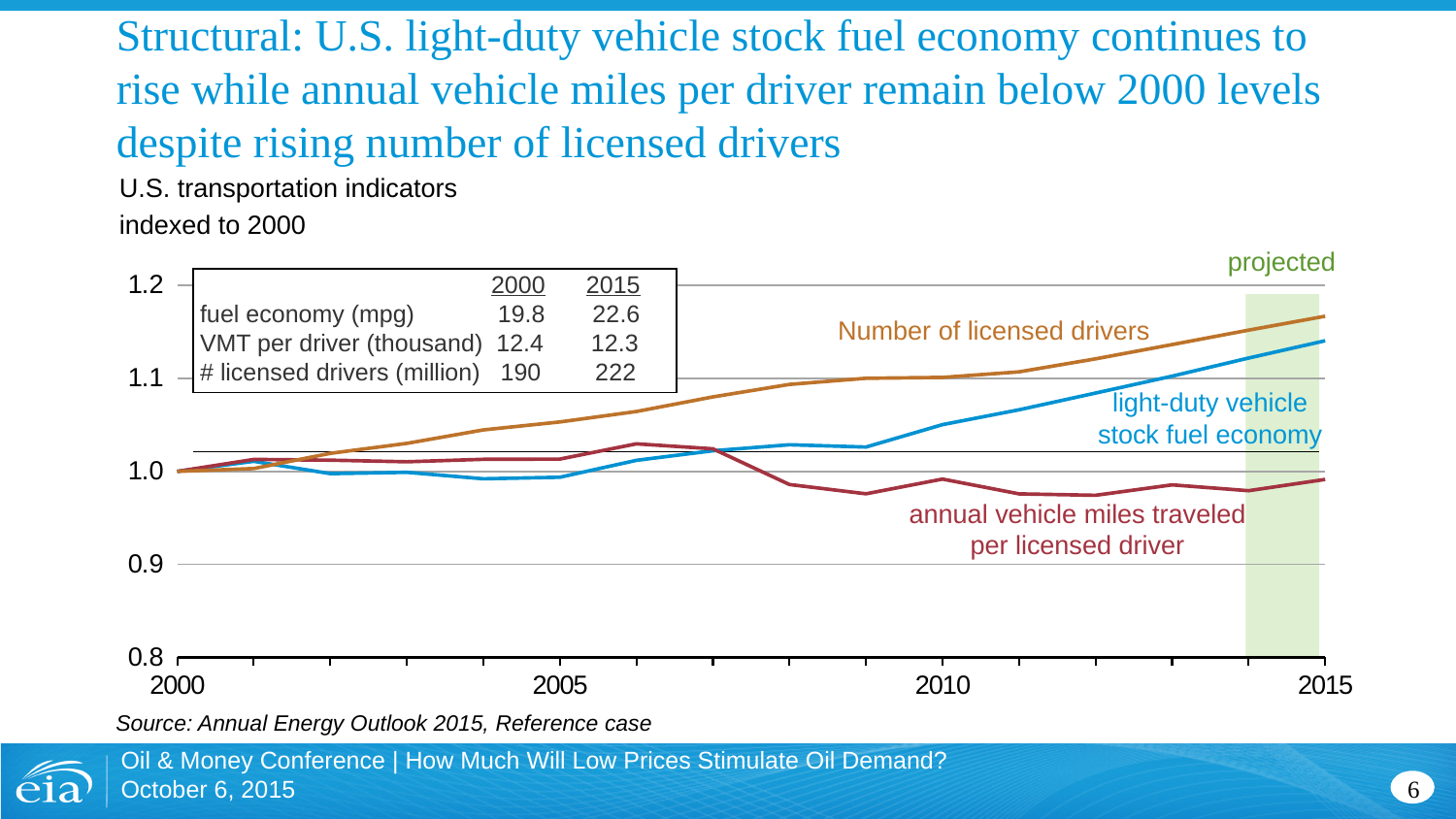
What kind of chart is shown on the slide? line chart How many series are plotted on the chart? 3 Which series has the lowest indexed value in 2015? annual vehicle miles traveled per licensed driver According to the inset table, what was fuel economy (mpg) in 2015? 22.6 Does the light-duty vehicle stock fuel economy series rise or fall from 2005 to 2015? rise Is the indexed value for annual vehicle miles traveled per licensed driver in 2009 greater or less than 1.0? less According to the inset table, what was the number of licensed drivers (million) in 2000? 190 According to the inset table, by how much did fuel economy (mpg) increase from 2000 to 2015? 2.8 What does the green shaded area at the right of the chart represent? projected In 2015, which is higher: the indexed value for light-duty vehicle stock fuel economy or for annual vehicle miles traveled per licensed driver? light-duty vehicle stock fuel economy Is the indexed value for Number of licensed drivers in 2015 greater or less than 1.1? greater Which series has the highest indexed value in 2015? Number of licensed drivers